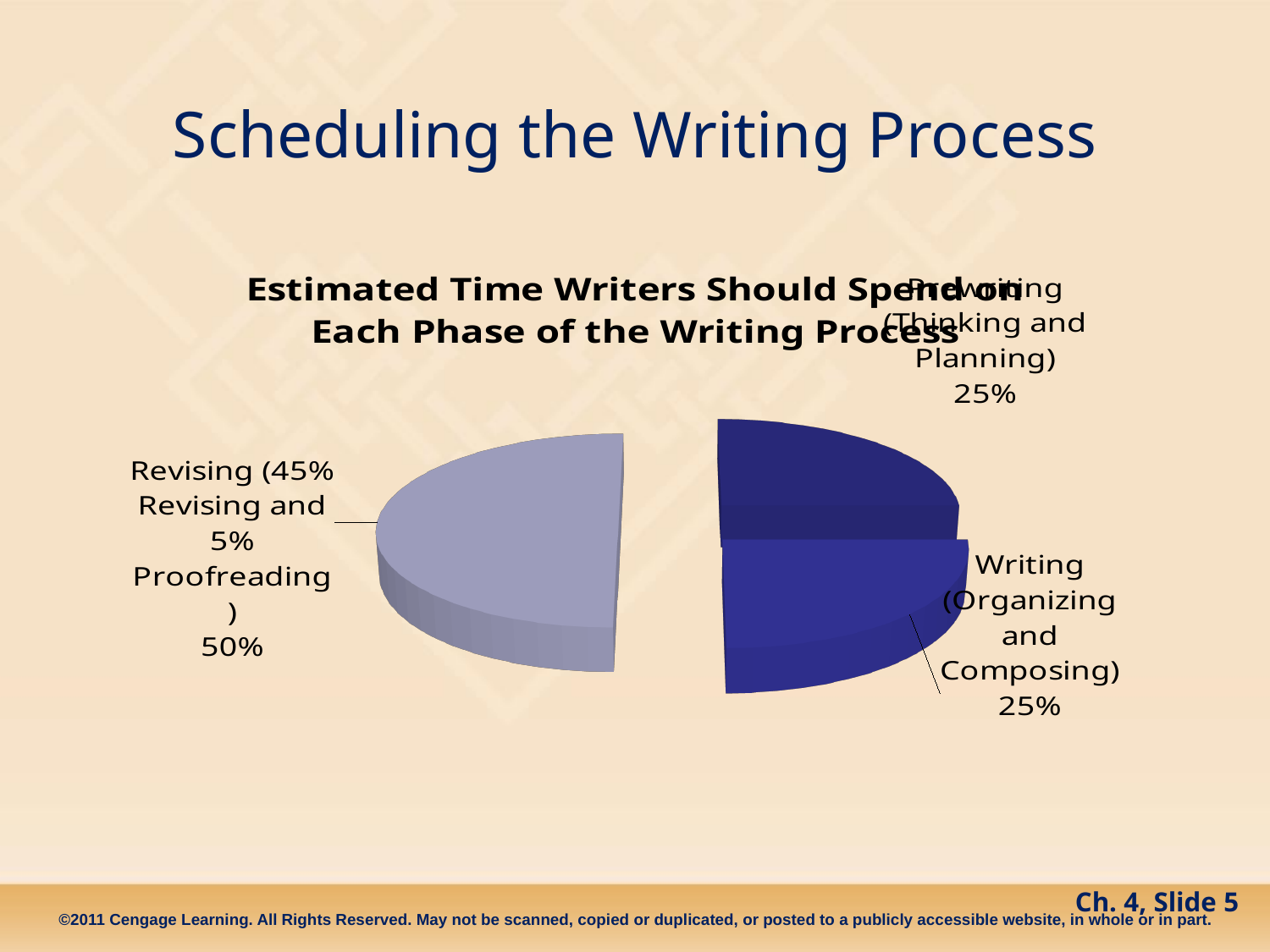
According to the Revising label, how much of the 50% is allotted to Proofreading? 5% What percentage of time does the chart allocate to Writing (Organizing and Composing)? 25% What is the difference between the share for Revising and the share for Prewriting (Thinking and Planning)? 25% What share of the pie does the Revising slice represent? 50% What kind of chart is shown on the slide? Pie chart How many slices does the pie chart have? 3 What percentage of time does the chart allocate to Prewriting (Thinking and Planning)? 25% What is the title of the pie chart? Estimated Time Writers Should Spend on Each Phase of the Writing Process What percentage of time does the chart allocate to Revising? 50% Which takes a larger share of time, Revising or Writing (Organizing and Composing)? Revising Which phase of the writing process takes the largest share of time in the chart? Revising Is the share for Writing (Organizing and Composing) greater or less than 50%? less